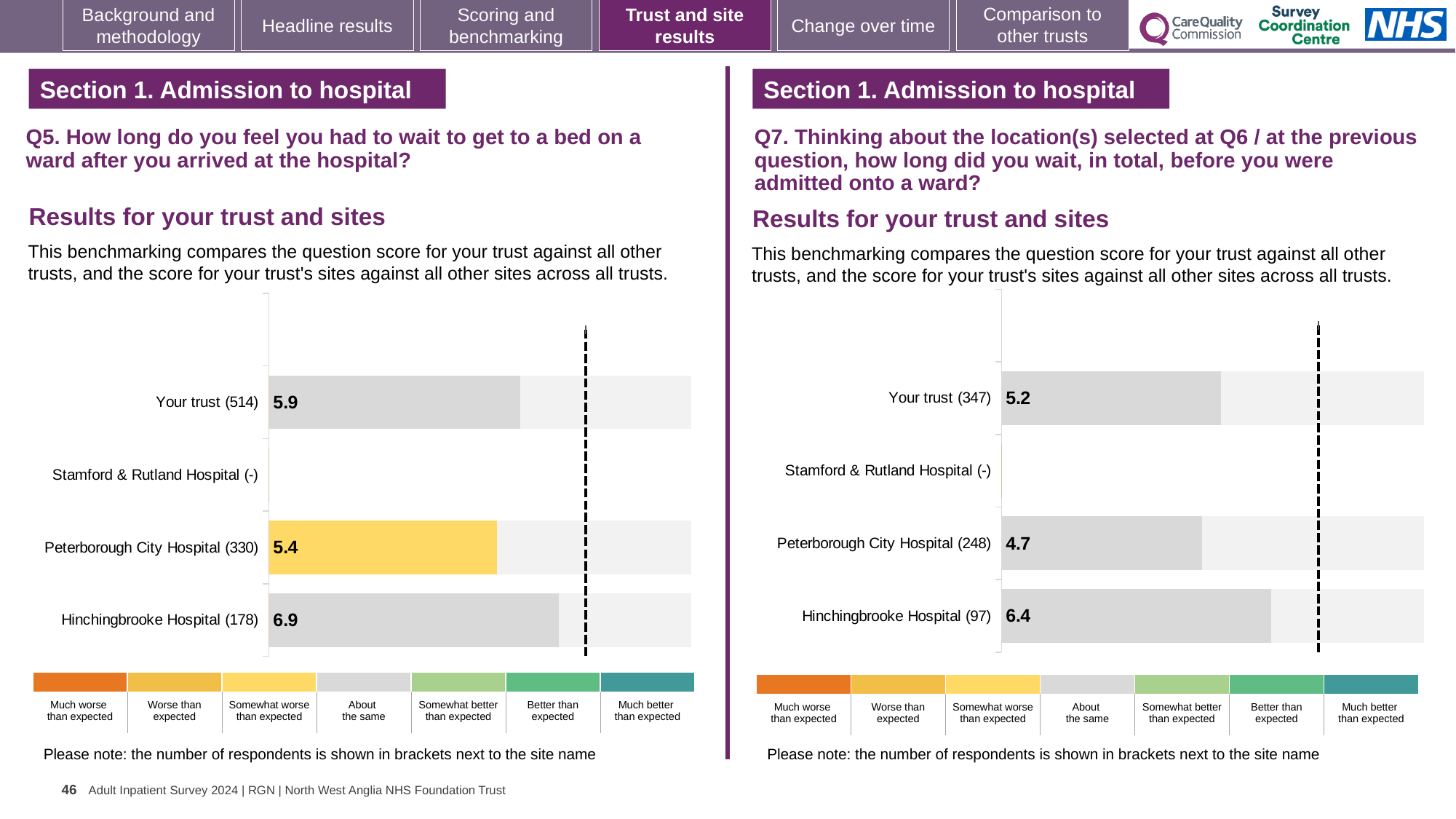
On the Q7 chart (right), which has the higher score: Your trust or Hinchingbrooke Hospital? Hinchingbrooke Hospital On the Q7 chart (right), which site has the lowest score among those with a value shown? Peterborough City Hospital On the Q7 chart (right), what is the score for Peterborough City Hospital? 4.7 On the Q7 chart (right), what is the score for Your trust? 5.2 What kind of chart is used on the Q7 chart (right)? Bar chart On the Q5 chart (left), what is the score for Hinchingbrooke Hospital? 6.9 On the Q5 chart (left), what is the score for Your trust? 5.9 On the Q5 chart (left), which benchmark category does the yellow colour of the Peterborough City Hospital bar indicate? Somewhat worse than expected How many rows (trust and sites) are listed on the Q5 chart (left)? 4 On the Q7 chart (right), what is the difference between the scores for Hinchingbrooke Hospital and Your trust? 1.2 On the Q5 chart (left), which site has the highest score? Hinchingbrooke Hospital On the Q5 chart (left), what is the difference between the scores for Hinchingbrooke Hospital and Peterborough City Hospital? 1.5